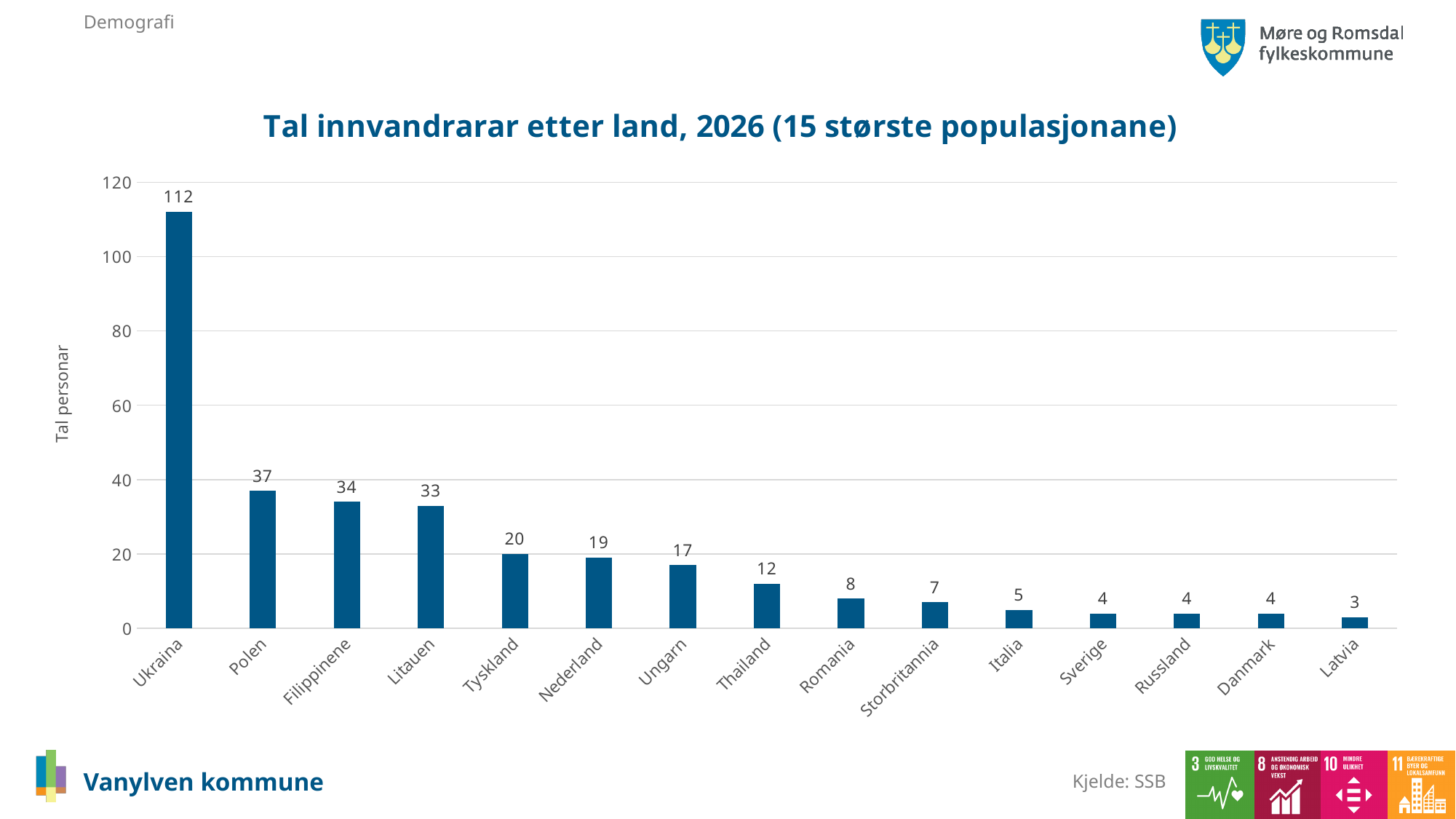
Is the value for Ukraina greater or less than 100? greater What is the value for Storbritannia? 7 How many countries are shown on the chart? 15 Which country has the highest value? Ukraina Which is larger, the value for Nederland or the value for Ungarn? Nederland What is the value for Polen? 37 Which country has the lowest value? Latvia What is the value for Tyskland? 20 What is the title of the chart? Tal innvandrarar etter land, 2026 (15 største populasjonane) What is the difference between the values for Filippinene and Litauen? 1 What kind of chart is this? bar chart What is the difference between the values for Ukraina and Polen? 75